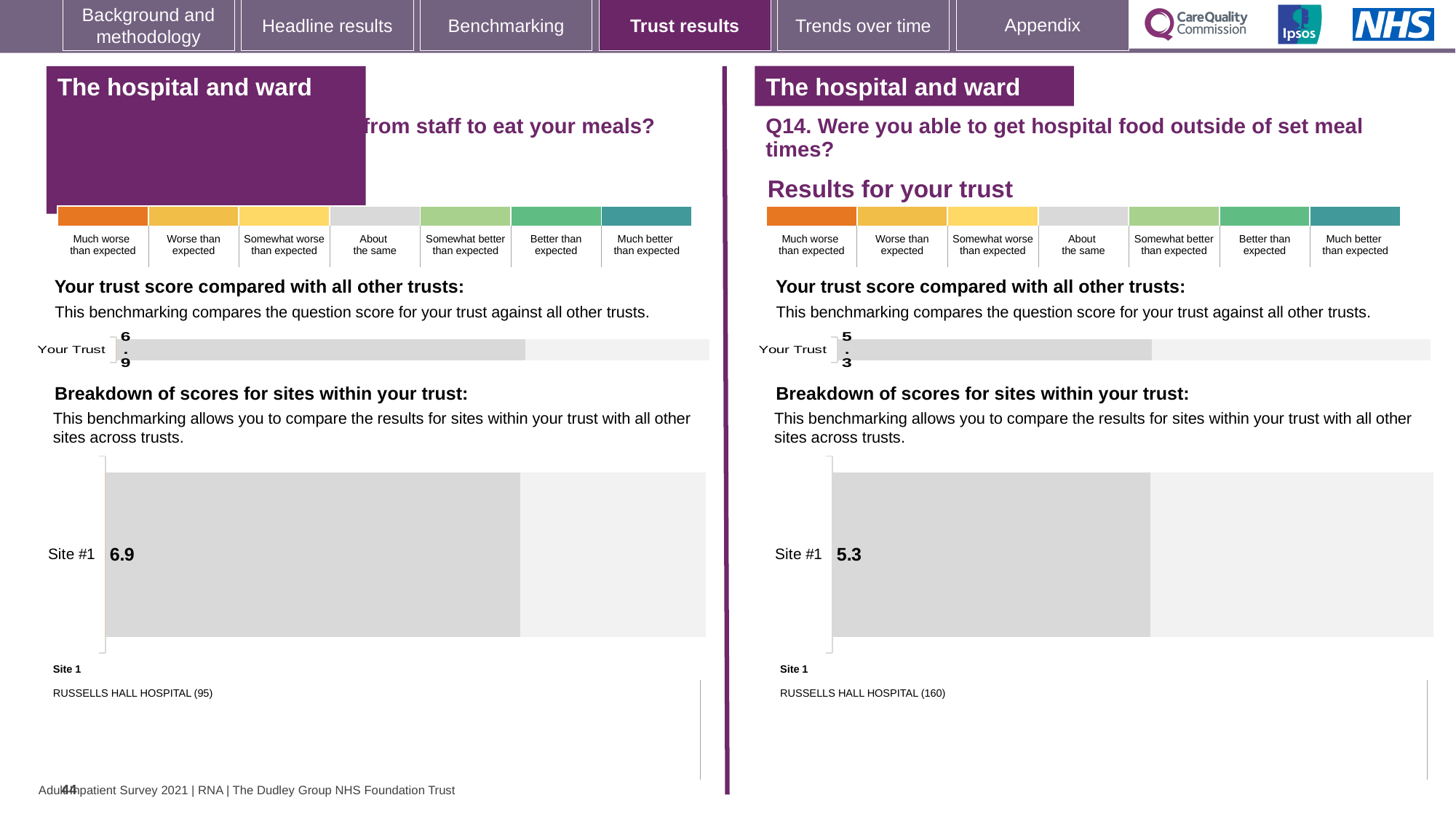
In the left 'Breakdown of scores for sites within your trust' chart, what is the score for Site #1? 6.9 According to the key below the right breakdown chart, which hospital is Site 1? RUSSELLS HALL HOSPITAL (160) What question number and text is the right half of the slide about? Q14. Were you able to get hospital food outside of set meal times? How many sites are plotted in the left 'Breakdown of scores for sites within your trust' chart? 1 What is the difference between the Site #1 score in the left breakdown chart and the Site #1 score in the right breakdown chart? 1.6 On the right half of the slide (Q14), what score is shown for 'Your Trust' in the 'Your trust score compared with all other trusts' chart? 5.3 What kind of chart is used for the 'Breakdown of scores for sites within your trust' on the left half of the slide? Bar chart How many sites are plotted in the right 'Breakdown of scores for sites within your trust' chart (Q14)? 1 In the left breakdown chart, is the Site #1 score equal to the 'Your Trust' score shown above it? Yes In the right 'Breakdown of scores for sites within your trust' chart (Q14), what is the score for Site #1? 5.3 On the left half of the slide, what score is shown for 'Your Trust' in the 'Your trust score compared with all other trusts' chart? 6.9 Which is larger: the Site #1 score in the left breakdown chart or the Site #1 score in the right breakdown chart? The left chart (6.9)